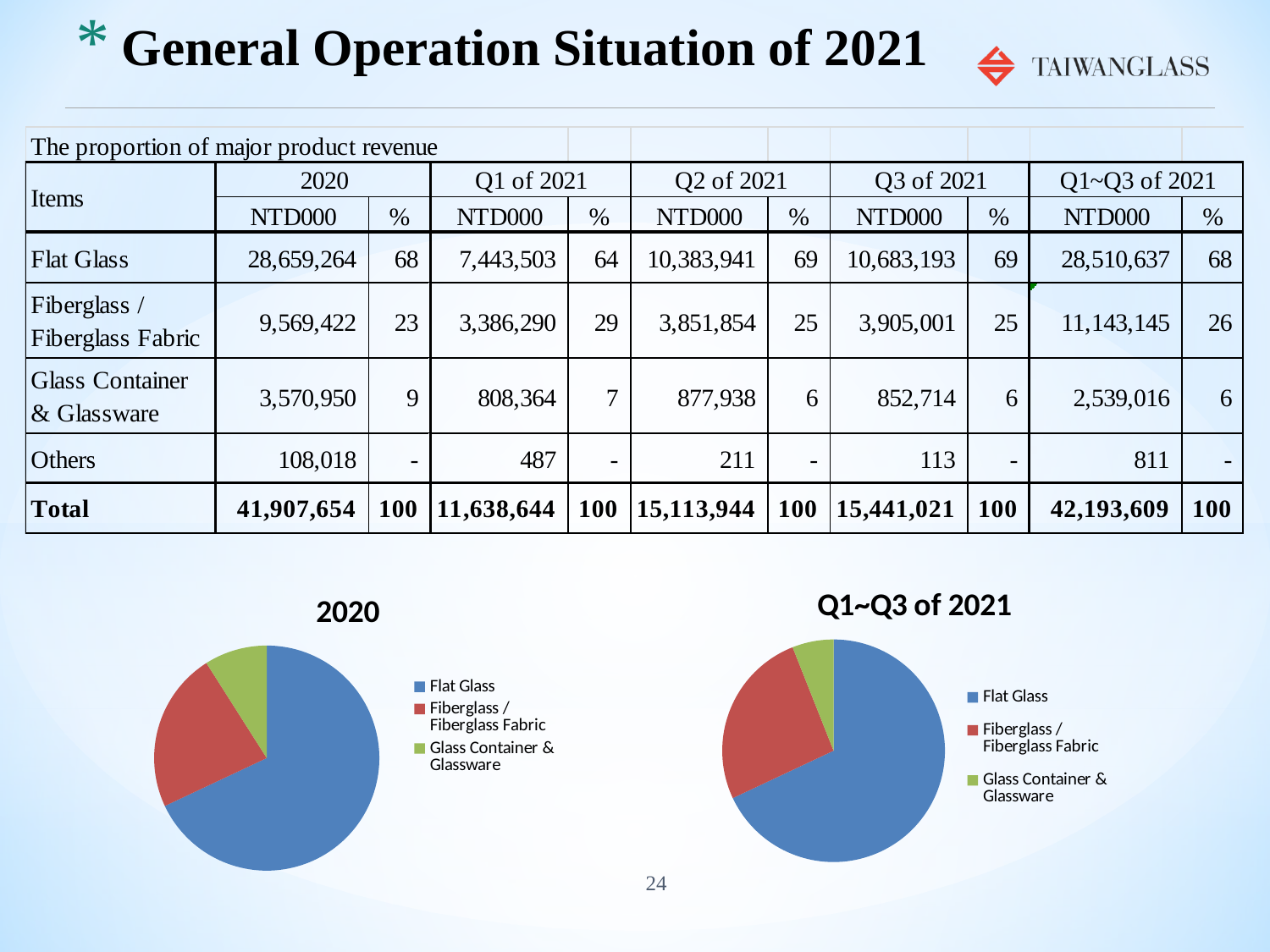
In the "2020" pie chart, which category has the largest slice? Flat Glass What kind of chart is the "2020" chart? pie chart In the "Q1~Q3 of 2021" pie chart, which category has the largest slice? Flat Glass In the "Q1~Q3 of 2021" pie chart, how many slices are there? 3 In the "2020" pie chart, what share of the pie does Flat Glass represent, according to the table on the slide? 68% In the "Q1~Q3 of 2021" pie chart, what share of the pie does Fiberglass / Fiberglass Fabric represent, according to the table on the slide? 26% In the "2020" pie chart, what colour is the Flat Glass slice? blue In the "Q1~Q3 of 2021" pie chart, which category has the smallest slice? Glass Container & Glassware In the "Q1~Q3 of 2021" pie chart, which slice is larger: Fiberglass / Fiberglass Fabric or Glass Container & Glassware? Fiberglass / Fiberglass Fabric What kind of chart is the "Q1~Q3 of 2021" chart? pie chart In the "2020" pie chart, how many entries does the legend list? 3 In the "2020" pie chart, which category has the smallest slice? Glass Container & Glassware